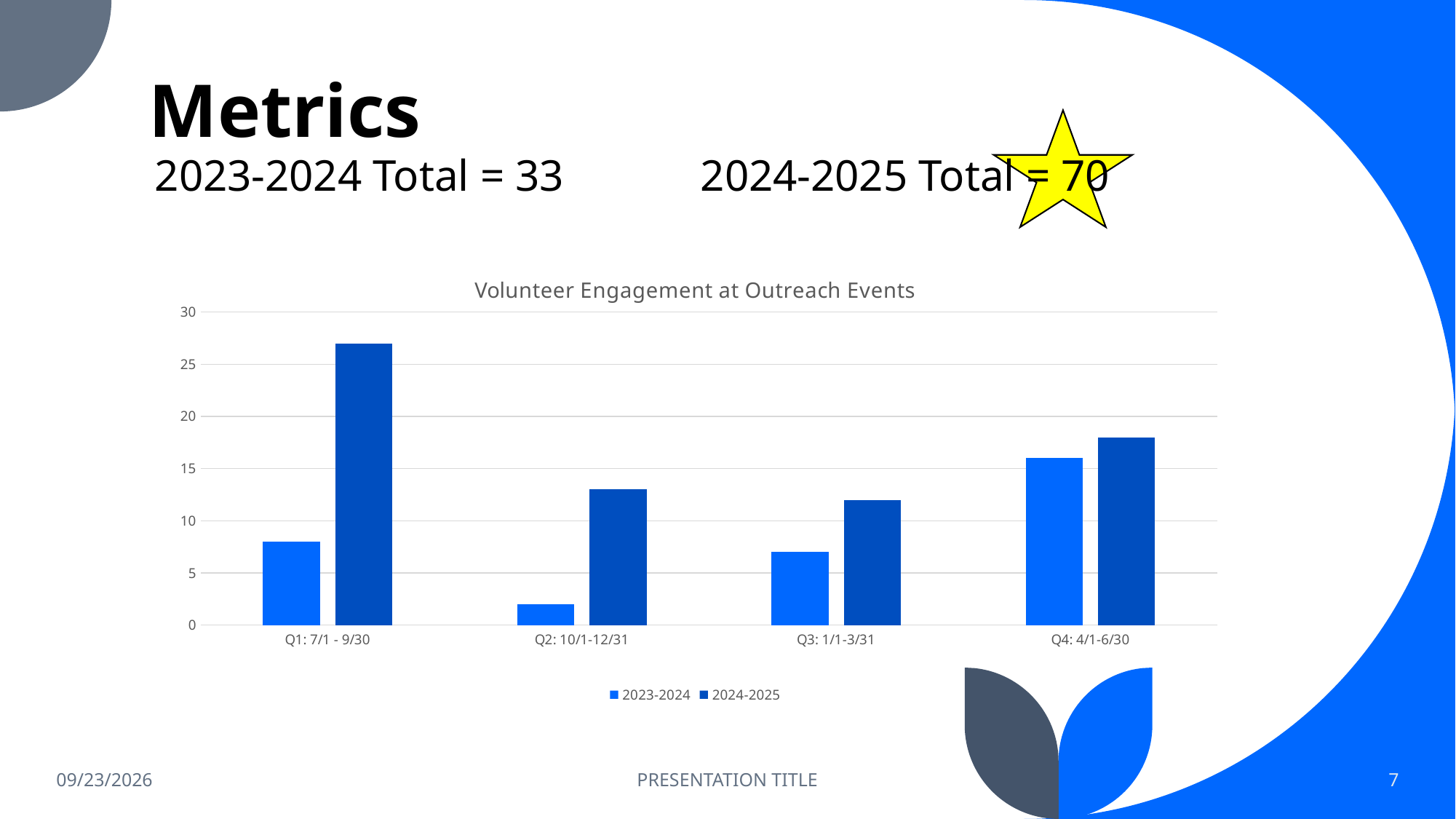
Is the 2023-2024 value for Q2: 10/1-12/31 greater or less than 5? less Which quarter has the highest 2024-2025 bar? Q1: 7/1 - 9/30 For Q3: 1/1-3/31, which series has the larger value, 2023-2024 or 2024-2025? 2024-2025 What is the title of the chart? Volunteer Engagement at Outreach Events Is the 2024-2025 value for Q4: 4/1-6/30 greater or less than 20? less Does the 2024-2025 series rise or fall from Q1: 7/1 - 9/30 to Q2: 10/1-12/31? fall How many series does the chart legend list? 2 Is the 2024-2025 value for Q1: 7/1 - 9/30 greater or less than 25? greater How many quarter categories are shown on the x axis? 4 What kind of chart is shown on the slide? bar chart What 2024-2025 total is stated on the slide above the chart? 70 Which quarter has the lowest 2023-2024 bar? Q2: 10/1-12/31